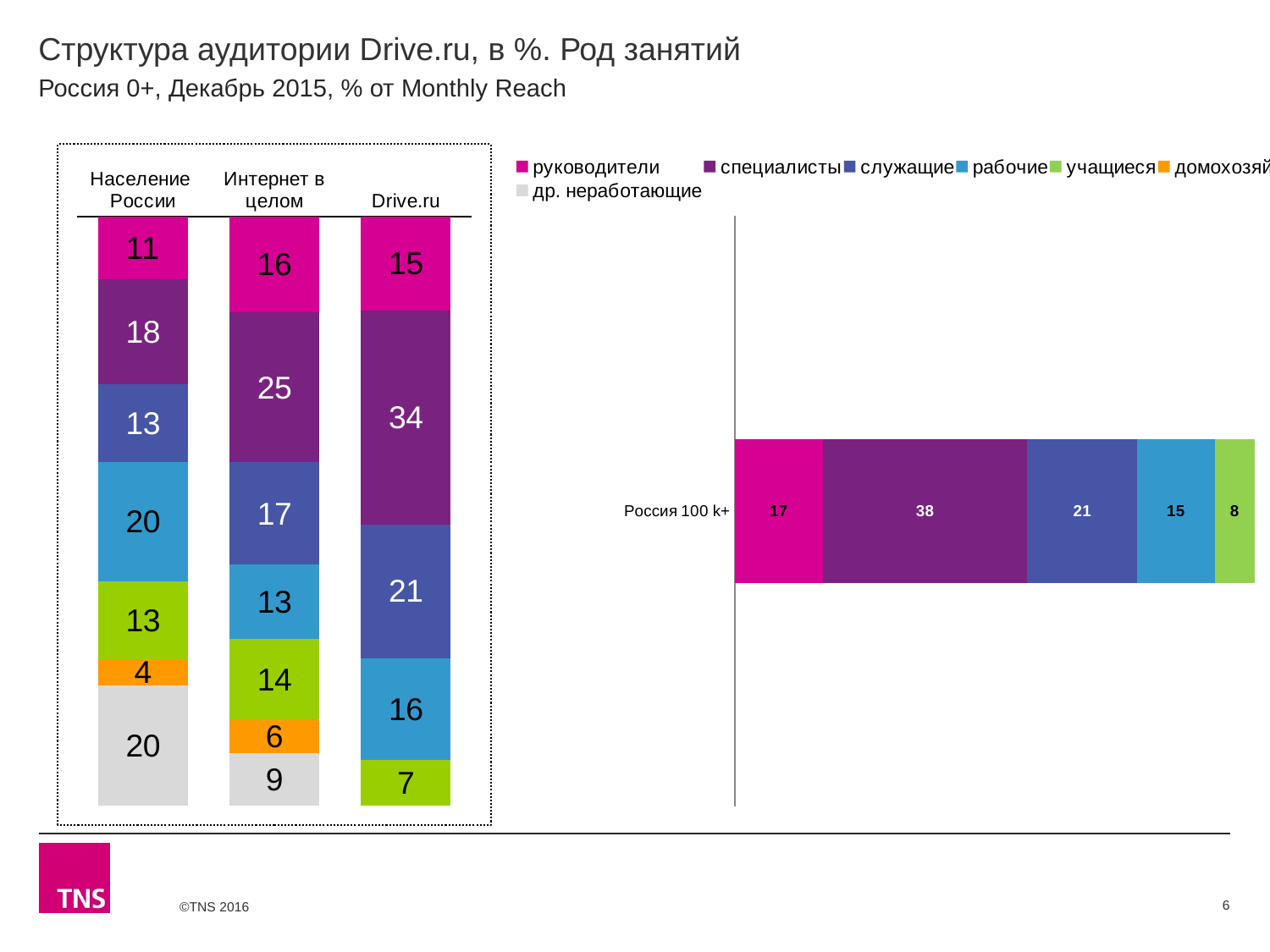
In the right horizontal bar chart for Россия 100 k+, what is the value of the учащиеся segment? 8 In the left stacked bar chart, what is the value of the специалисты segment for Drive.ru? 34 How many bars are shown in the left stacked bar chart? 3 What type of chart is shown on the right side of the slide? Stacked bar chart In the left stacked bar chart, what is the value of the др. неработающие segment for Население России? 20 In the left stacked bar chart, which of the three bars has the largest специалисты segment? Drive.ru In the left stacked bar chart, what is the difference between the специалисты values for Drive.ru and Население России? 16 In the left stacked bar chart, what is the value of the руководители segment for Интернет в целом? 16 In the left stacked bar chart, is the служащие value larger for Drive.ru or for Интернет в целом? Drive.ru In the left stacked bar chart, which of the three bars has the smallest учащиеся segment? Drive.ru In the right horizontal bar chart for Россия 100 k+, what is the value of the специалисты segment? 38 How many series does the legend list? 7